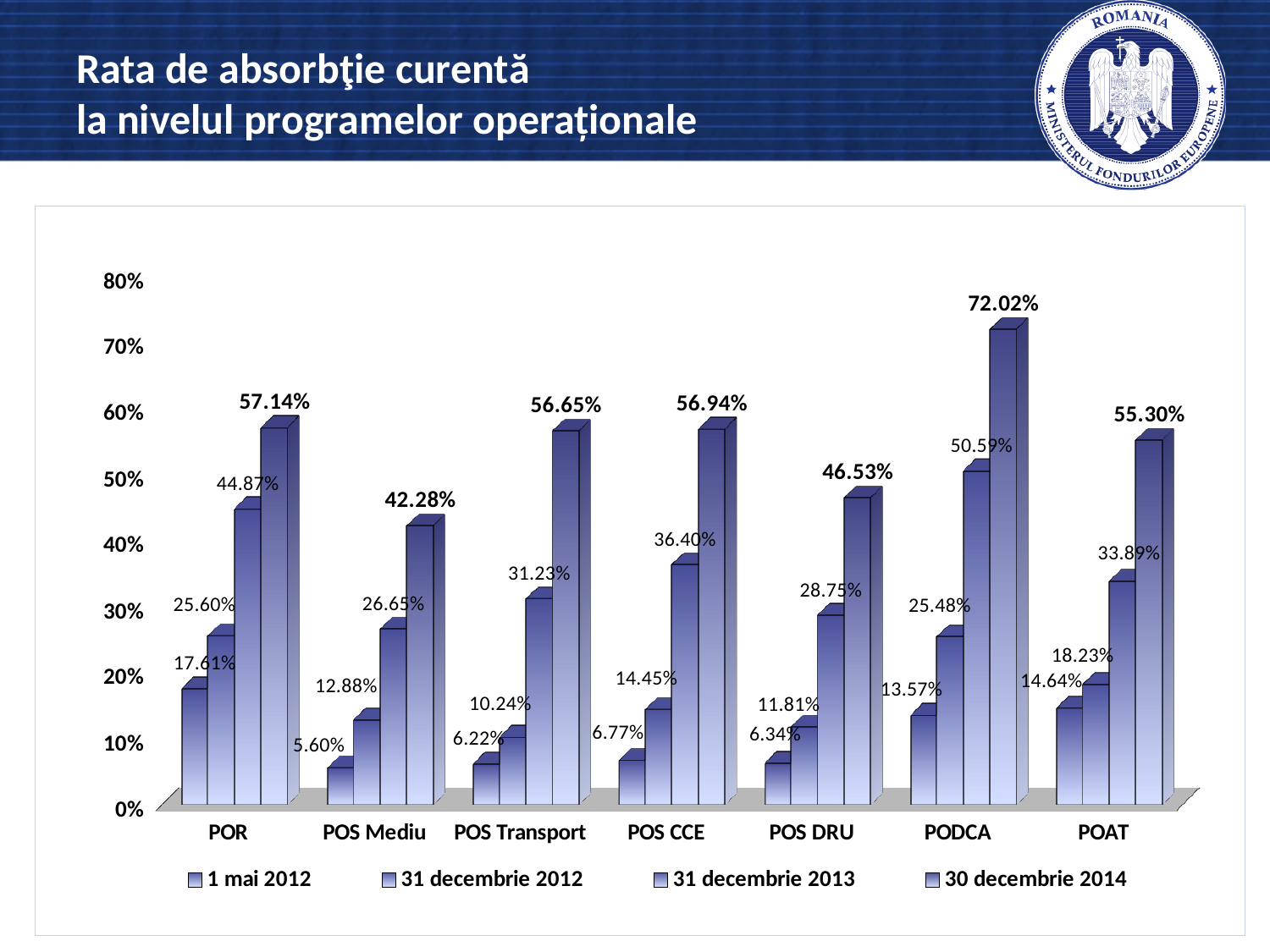
What is the value for PODCA in the 30 decembrie 2014 series? 72.02% How many series does the legend list? 4 Which is larger for POS CCE: the 31 decembrie 2013 value or the 31 decembrie 2012 value? 31 decembrie 2013 What is the value for POS Mediu in the 1 mai 2012 series? 5.60% What is the difference between the 30 decembrie 2014 value and the 31 decembrie 2013 value for POR? 12.27% What kind of chart is shown on the slide? Bar chart What is the value for POAT in the 31 decembrie 2012 series? 18.23% What is the value for POS Transport in the 31 decembrie 2013 series? 31.23% Which category has the lowest value in the 1 mai 2012 series? POS Mediu Which category has the highest value in the 30 decembrie 2014 series? PODCA For POS DRU, do the values rise or fall from 1 mai 2012 to 30 decembrie 2014? Rise How many categories (operational programmes) are shown on the x axis? 7